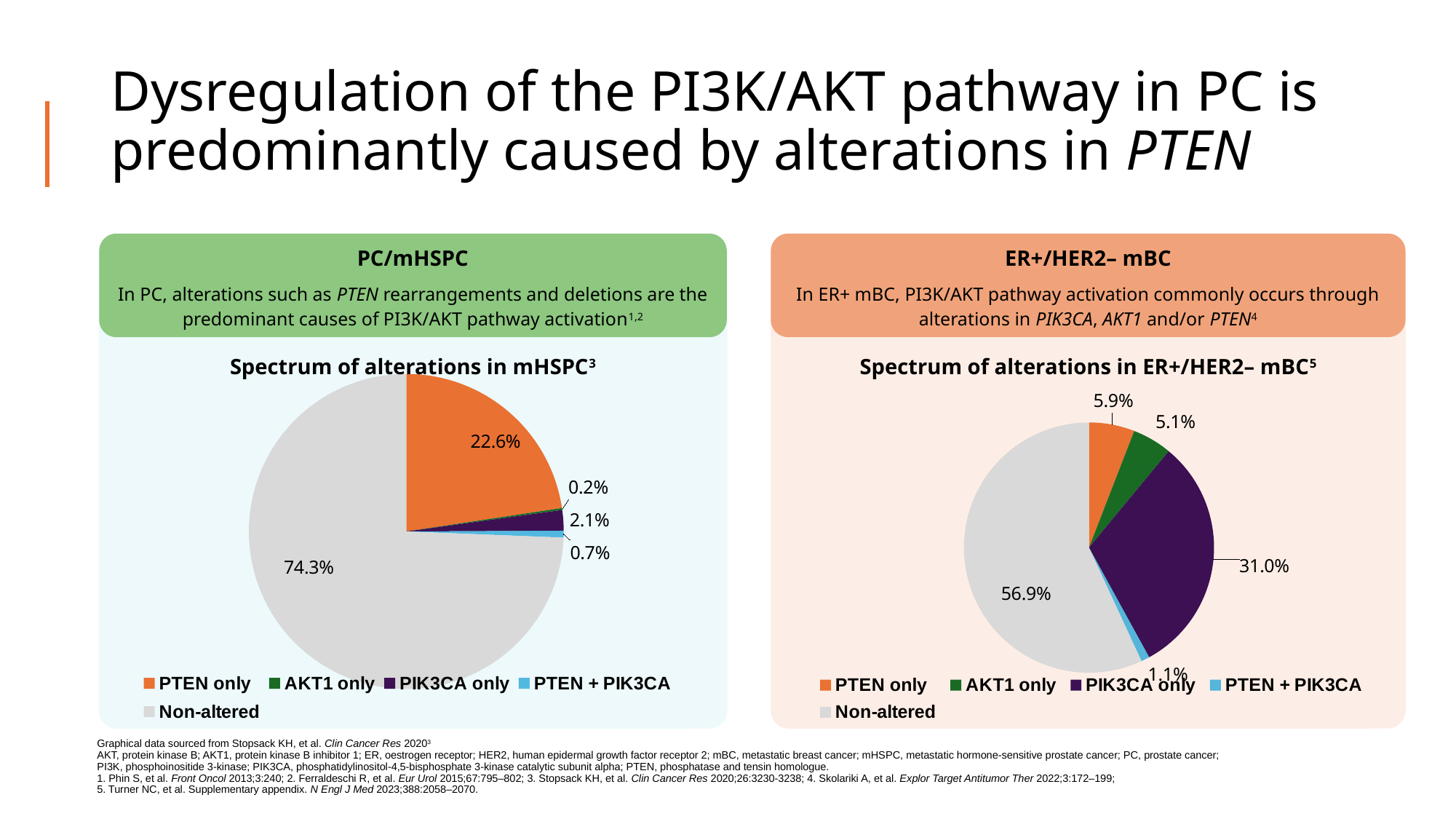
In the 'Spectrum of alterations in ER+/HER2– mBC' pie chart, what percentage is shown for PTEN + PIK3CA? 1.1% In the 'Spectrum of alterations in mHSPC' pie chart, what percentage is shown for PTEN only? 22.6% In the 'Spectrum of alterations in ER+/HER2– mBC' pie chart, which is larger: PTEN only or PIK3CA only? PIK3CA only In the 'Spectrum of alterations in ER+/HER2– mBC' pie chart, what percentage is shown for Non-altered? 56.9% How many categories does the legend of the 'Spectrum of alterations in mHSPC' chart list? 5 What is the difference between the PTEN only percentages in the mHSPC chart and the ER+/HER2– mBC chart? 16.7% In the 'Spectrum of alterations in ER+/HER2– mBC' pie chart, which category has the largest share? Non-altered In the 'Spectrum of alterations in ER+/HER2– mBC' pie chart, what percentage is shown for PIK3CA only? 31.0% In the 'Spectrum of alterations in mHSPC' pie chart, what percentage is shown for PIK3CA only? 2.1% What type of chart is used for 'Spectrum of alterations in ER+/HER2– mBC'? Pie chart In the 'Spectrum of alterations in mHSPC' pie chart, what percentage is shown for Non-altered? 74.3% In the 'Spectrum of alterations in mHSPC' pie chart, which category has the smallest share? AKT1 only